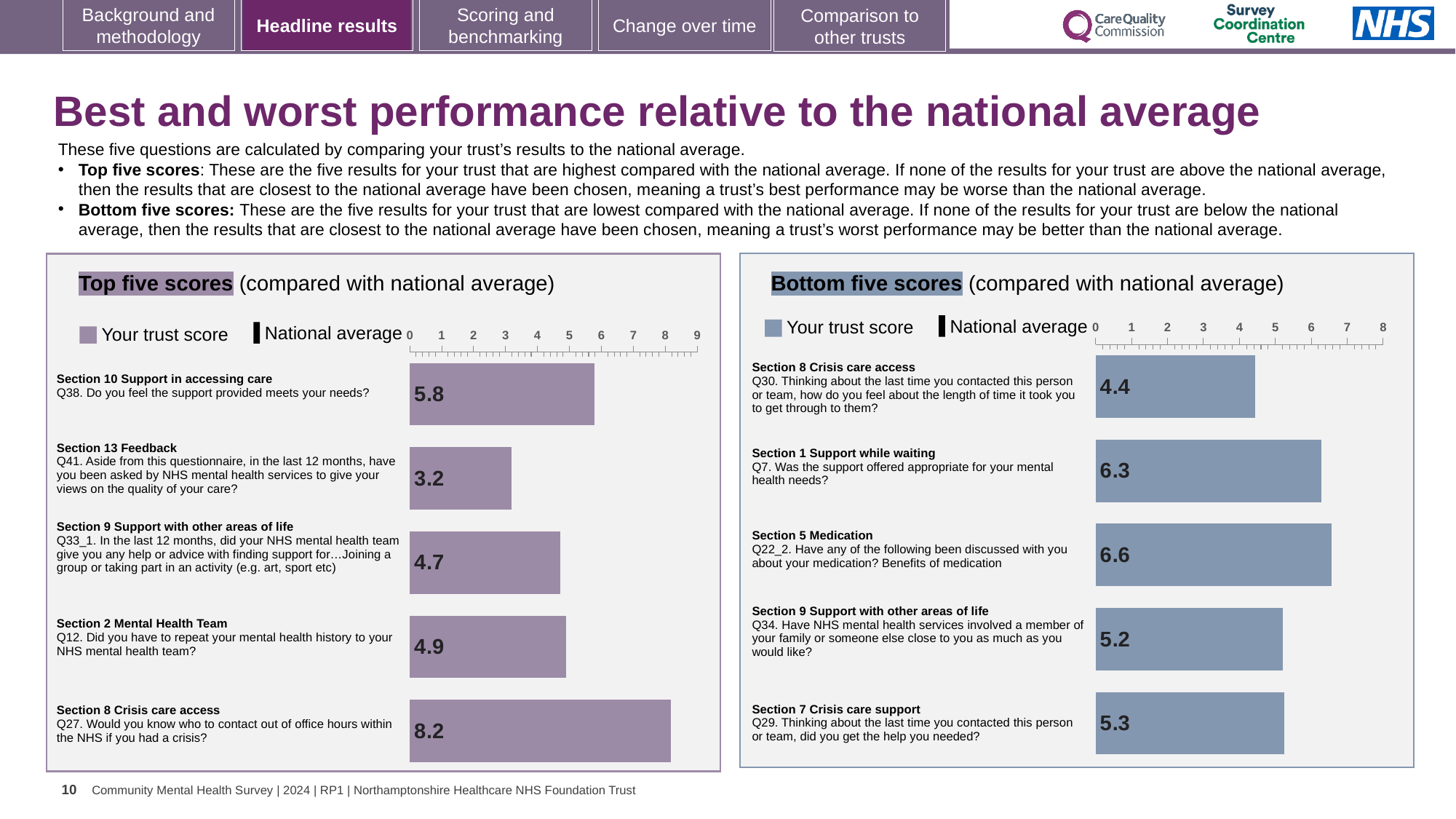
How many entries does the legend of the Bottom five scores chart list? 2 In the Top five scores chart, which question has the highest trust score? Q27 In the Bottom five scores chart, what is the trust score for Q22_2 (Section 5 Medication)? 6.6 In the Top five scores chart, which has the larger trust score, Q12 or Q33_1? Q12 In the Top five scores chart, which question has the lowest trust score? Q41 In the Top five scores chart, what is the trust score for Q27 (Section 8 Crisis care access)? 8.2 In the Bottom five scores chart, which question has the lowest trust score? Q30 In the Bottom five scores chart, what is the trust score for Q30 (Section 8 Crisis care access)? 4.4 How many bars are shown in the Bottom five scores chart? 5 What type of chart is the Top five scores chart? Bar chart In the Bottom five scores chart, what is the difference between the trust scores for Q22_2 and Q30? 2.2 In the Top five scores chart, what is the trust score for Q38 (Section 10 Support in accessing care)? 5.8